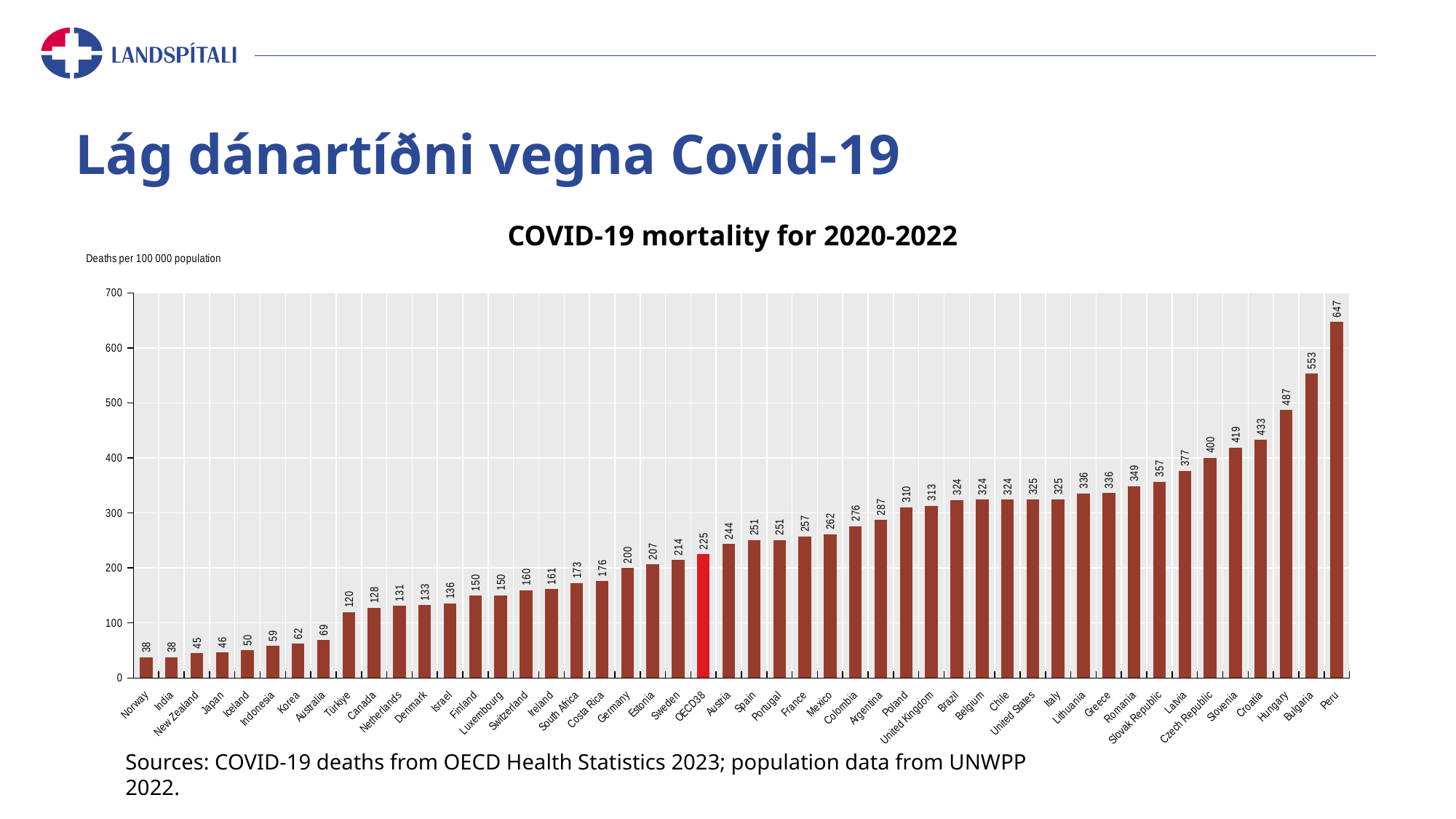
Do the values rise or fall from left to right along the x axis? Rise What is the value for Iceland? 50 Which country has the highest COVID-19 mortality in the chart? Peru Which bar is highlighted in red? OECD38 Which has a higher value, Germany or Sweden? Sweden What is the value for the United States? 325 What is the difference between the values for Peru and Bulgaria? 94 What is the difference between the values for OECD38 and Iceland? 175 What is the lowest value shown in the chart? 38 How many bars are shown in the chart? 48 What is the value for OECD38? 225 What kind of chart is shown on the slide? Bar chart